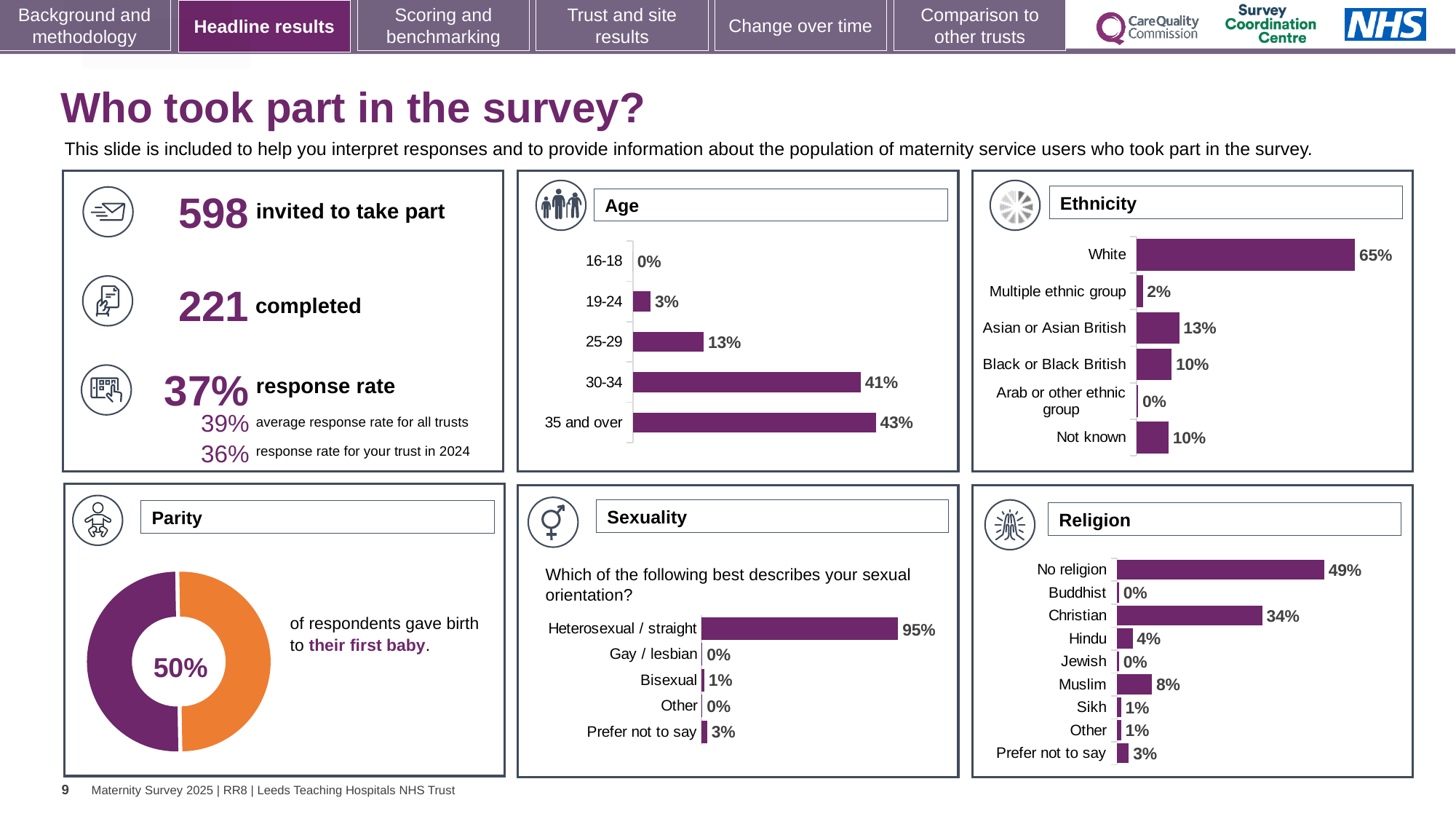
In the Religion chart, what percentage of respondents were Christian? 34% What kind of chart is the Parity chart? Doughnut chart In the Ethnicity chart, which category has the highest percentage? White In the Age chart, how many age categories are shown? 5 In the Ethnicity chart, what percentage of respondents were White? 65% In the Parity chart, what percentage of respondents gave birth to their first baby? 50% In the Sexuality chart, which is larger, Bisexual or Prefer not to say? Prefer not to say In the Age chart, what percentage of respondents were aged 30-34? 41% In the Age chart, which age group has the highest percentage? 35 and over In the Sexuality chart, what percentage of respondents answered Heterosexual / straight? 95% In the Ethnicity chart, what is the difference between the percentages for Asian or Asian British and Black or Black British? 3% In the Religion chart, how many religion categories are shown? 9